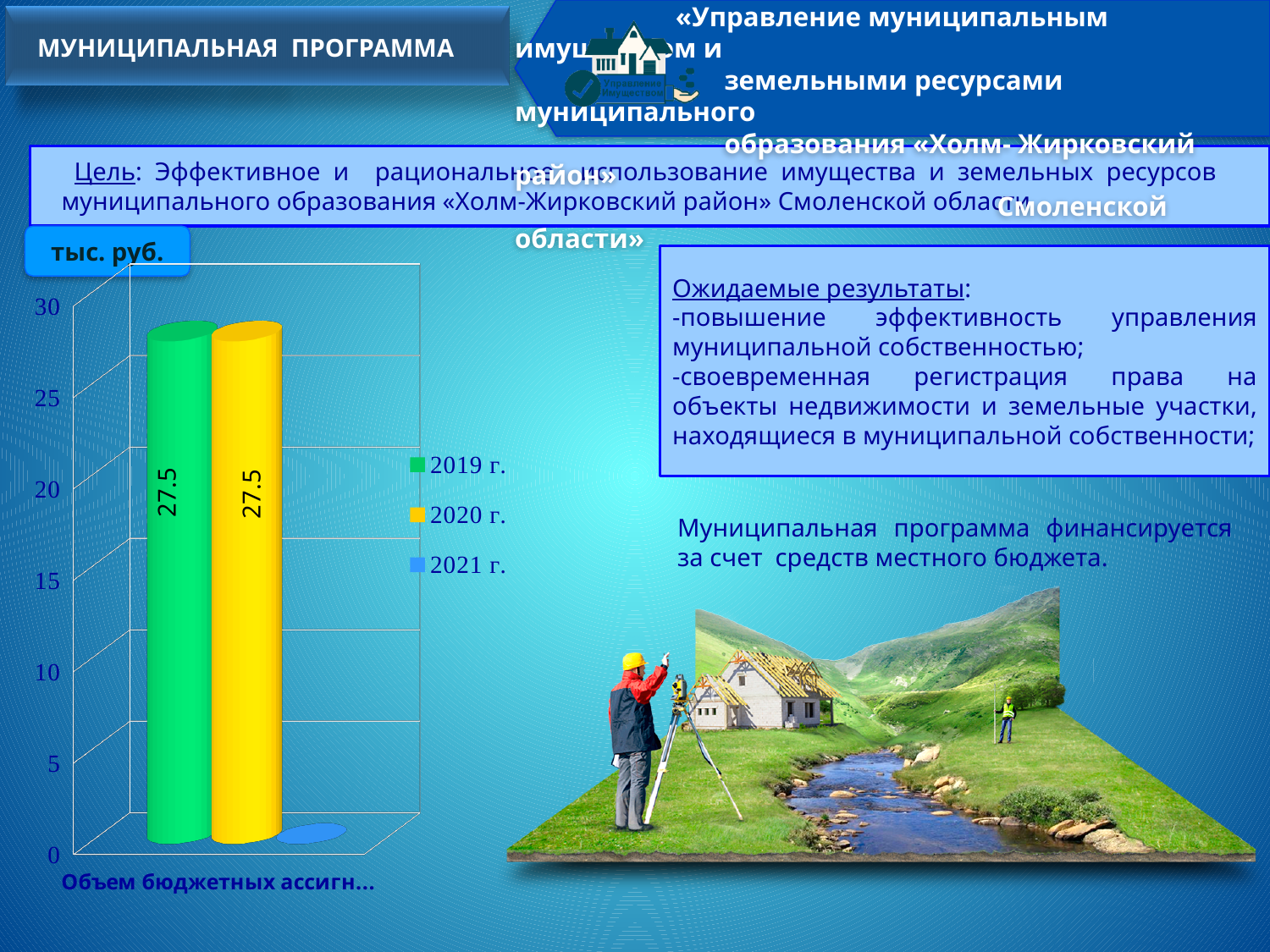
How many categories are shown on the x axis? 1 Is the value for 2020 г. larger than, smaller than, or equal to the value for 2019 г.? equal How many series does the legend list? 3 Is the value for 2021 г. greater or less than 5? less What kind of chart is shown on the slide? bar chart What is the value for the 2020 г. series? 27.5 What unit is shown above the chart's vertical axis? тыс. руб. What colour represents the 2020 г. series in the legend? yellow What is the value for the 2019 г. series? 27.5 Is the value for 2019 г. greater or less than 25? greater Which series has the lowest value? 2021 г. What is the difference between the values for 2019 г. and 2020 г.? 0